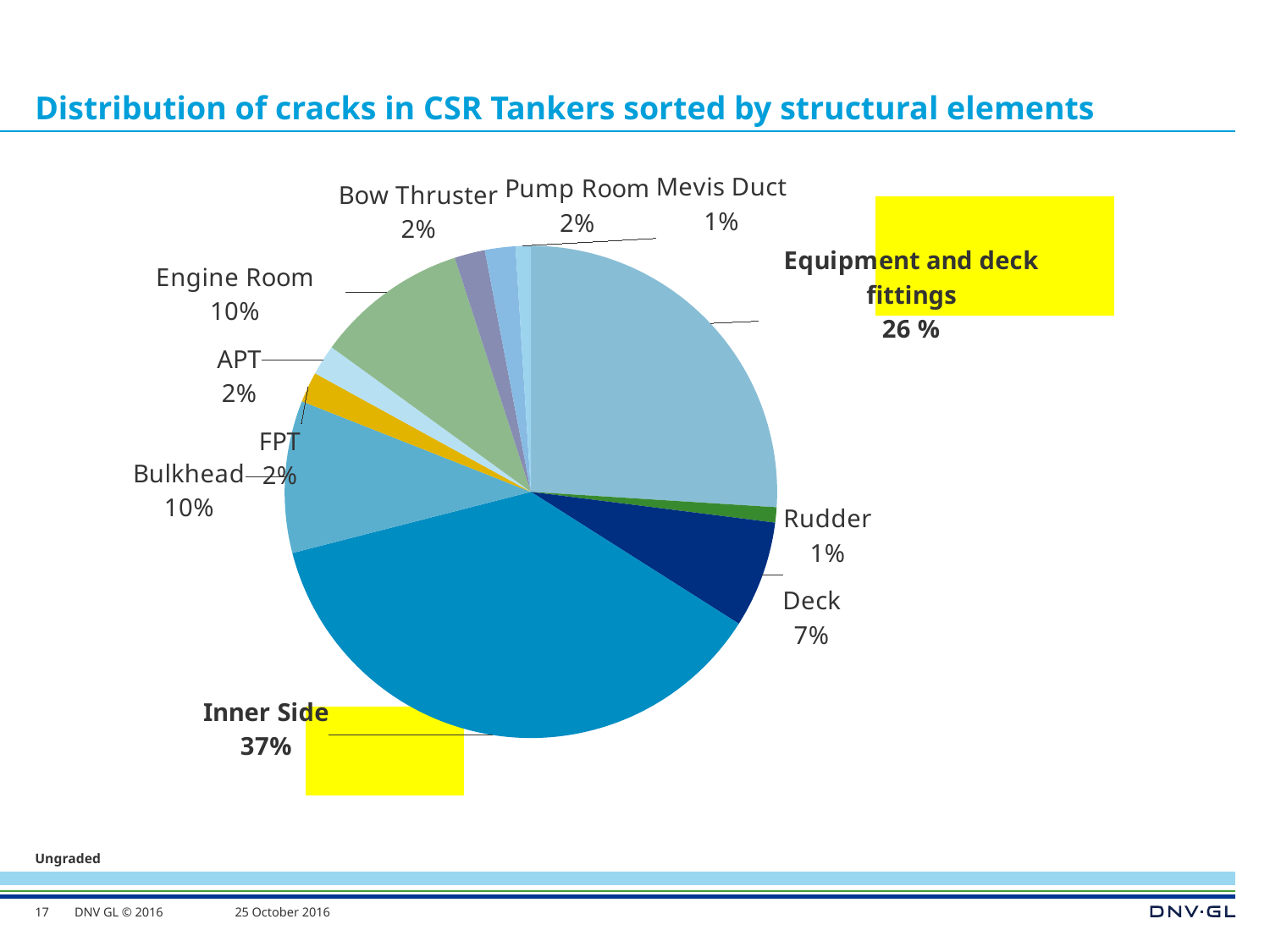
What type of chart is shown on the slide? pie chart What percentage is shown for Mevis Duct? 1% What share of cracks is attributed to Equipment and deck fittings? 26 % What is the difference in percentage points between Inner Side and Equipment and deck fittings? 11 What is the combined share of Bulkhead and Engine Room? 20% What percentage is shown for Engine Room? 10% Which structural element has the largest share of cracks? Inner Side How many structural element categories are shown in the pie chart? 11 Which structural element has a larger share of cracks, Bulkhead or Deck? Bulkhead What share of cracks is attributed to Inner Side? 37% What percentage is shown for Deck? 7% What is the title of the chart? Distribution of cracks in CSR Tankers sorted by structural elements